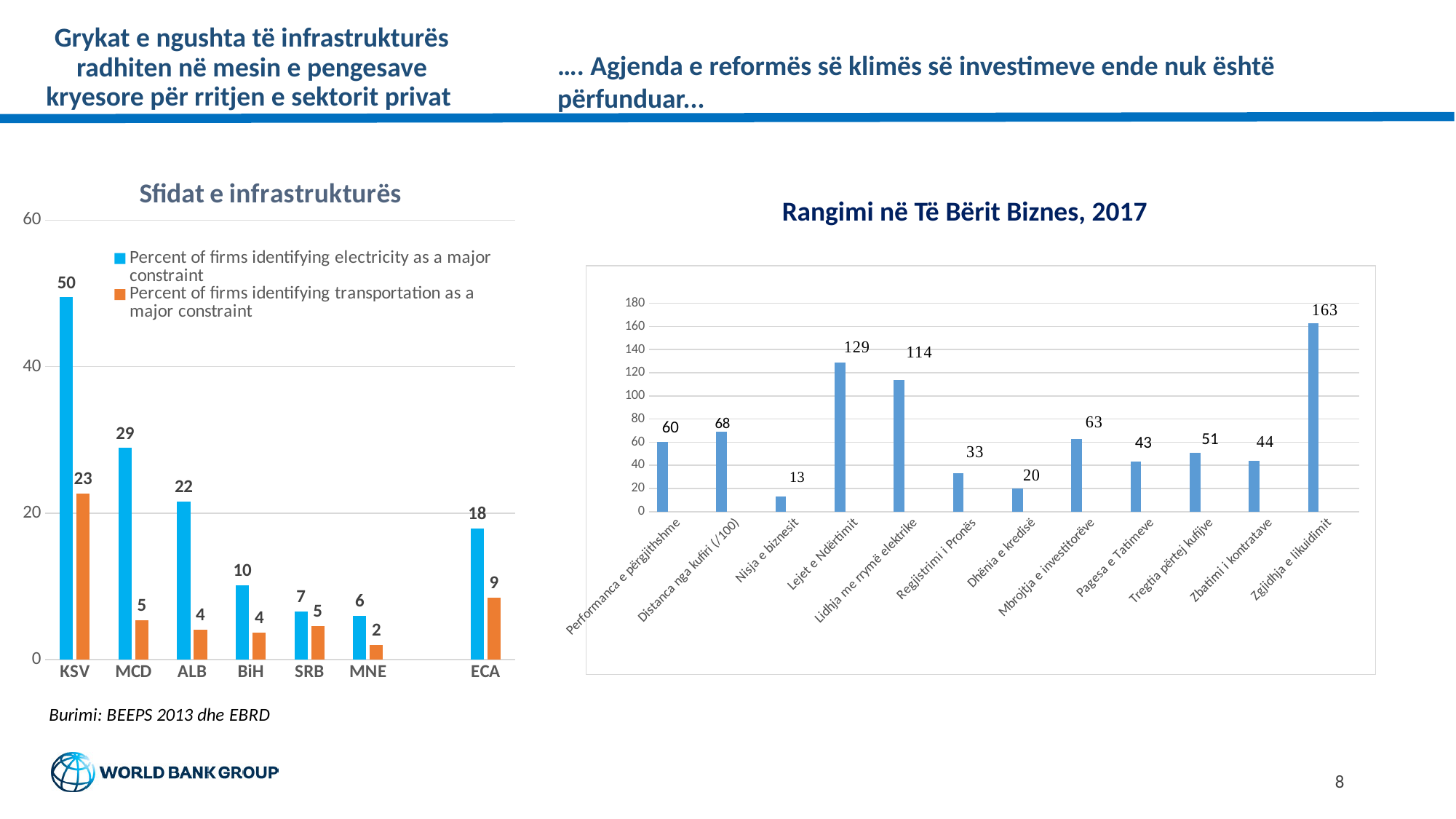
In the 'Sfidat e infrastrukturës' chart, which category has the lowest value for transportation as a major constraint? MNE In the 'Rangimi në Të Bërit Biznes, 2017' chart, which category has the lowest value? Nisja e biznesit In the 'Sfidat e infrastrukturës' chart, what is the difference between the electricity and transportation values for MCD? 24 In the 'Rangimi në Të Bërit Biznes, 2017' chart, what is the difference between Zgjidhja e likuidimit and Lidhja me rrymë elektrike? 49 In the 'Rangimi në Të Bërit Biznes, 2017' chart, which is larger: Pagesa e Tatimeve or Tregtia përtej kufijve? Tregtia përtej kufijve In the 'Sfidat e infrastrukturës' chart, what is the percent of firms identifying transportation as a major constraint for ECA? 9 In the 'Rangimi në Të Bërit Biznes, 2017' chart, which category has the highest value? Zgjidhja e likuidimit In the 'Sfidat e infrastrukturës' chart, how many categories are shown on the x axis? 7 In the 'Sfidat e infrastrukturës' chart, how many series does the legend list? 2 In the 'Sfidat e infrastrukturës' chart, what is the percent of firms identifying electricity as a major constraint for KSV? 50 In the 'Rangimi në Të Bërit Biznes, 2017' chart, what is the value for Lejet e Ndërtimit? 129 What kind of chart is 'Rangimi në Të Bërit Biznes, 2017'? Bar chart